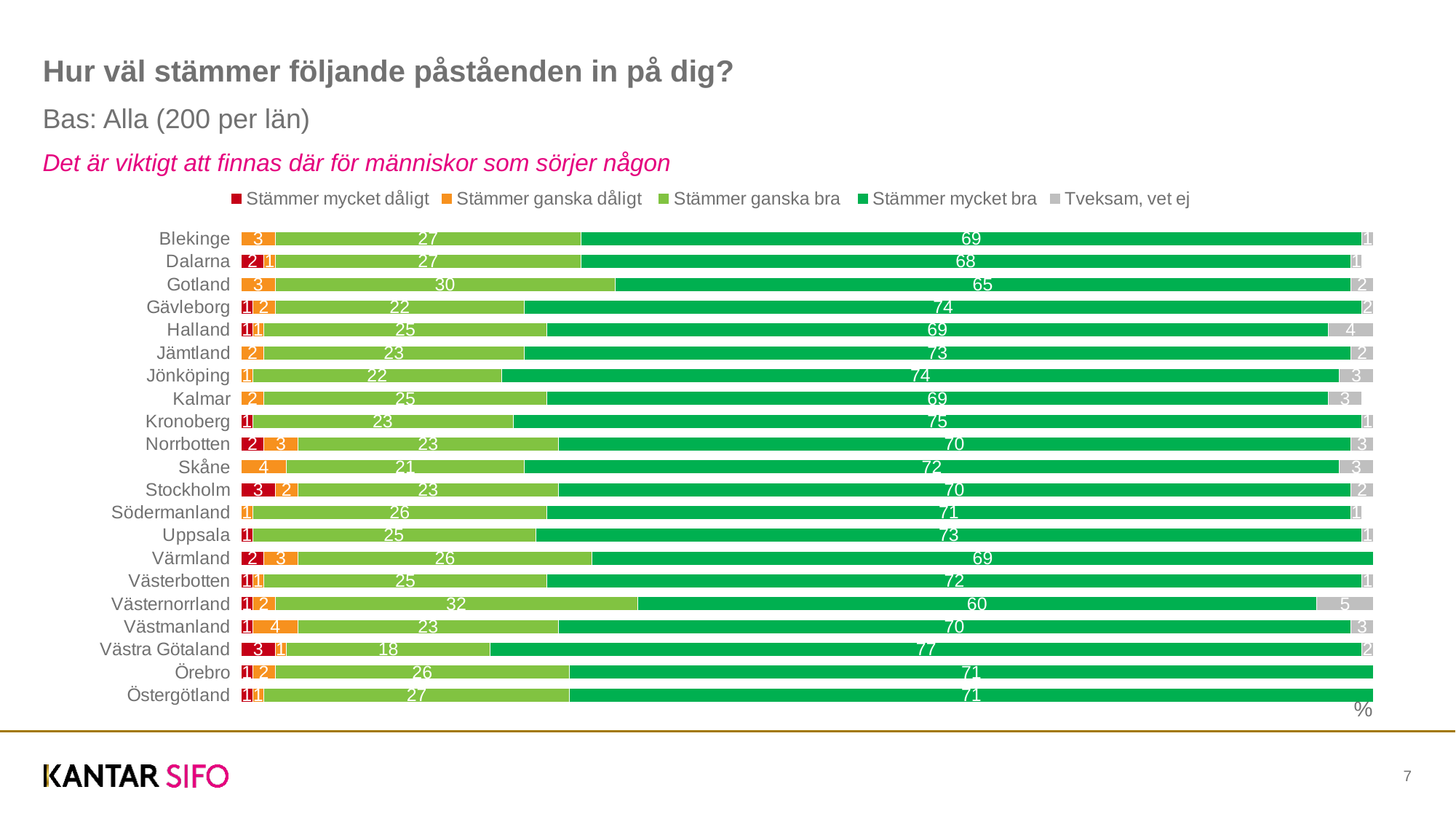
How many counties (categories) are shown in the chart? 21 What is the difference between the 'Stämmer mycket bra' values for Västra Götaland and Västernorrland? 17 What is the value of 'Stämmer ganska bra' for Västernorrland? 32 Which is larger: the 'Stämmer ganska bra' value for Gotland or for Skåne? Gotland Which county has the lowest value for 'Stämmer mycket bra'? Västernorrland How many series does the legend list? 5 What is the value of 'Tveksam, vet ej' for Halland? 4 Which county has the highest value for 'Stämmer mycket bra'? Västra Götaland Which county has the highest value for 'Tveksam, vet ej'? Västernorrland What is the value of 'Stämmer mycket bra' for Västra Götaland? 77 What kind of chart is shown on the slide? Stacked bar chart What is the value of 'Stämmer ganska dåligt' for Skåne? 4